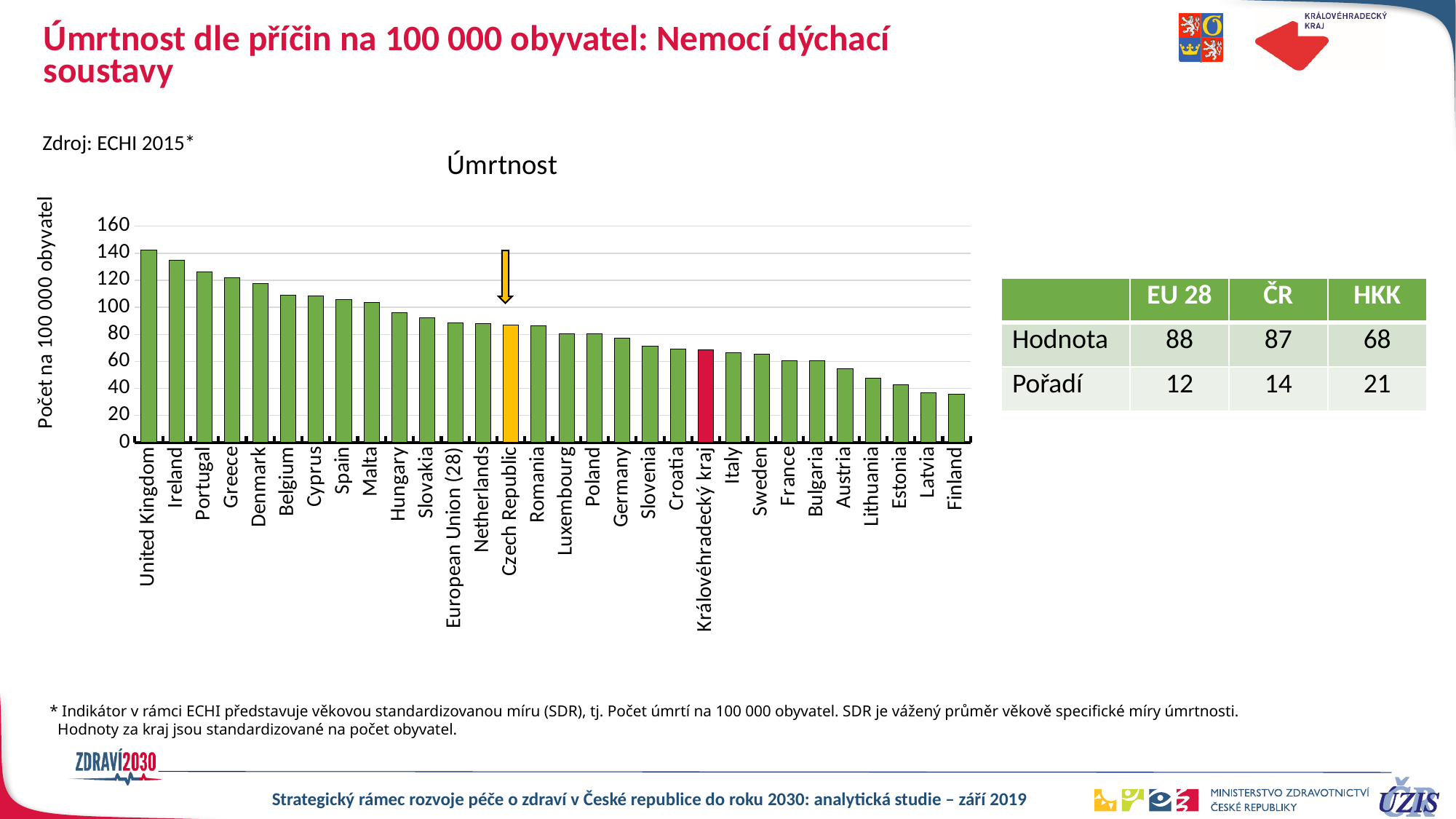
Is the value for Lithuania greater or less than 60? less Is the value for Ireland greater or less than 120? greater Which category has the highest value in the chart? United Kingdom Which has a larger value, Spain or Italy? Spain What is the difference between the values for European Union (28) and Královéhradecký kraj? 20 Do the values rise or fall from left to right along the x axis? fall What is the value for Královéhradecký kraj? 68 How many categories (bars) does the chart show? 30 What is the value for Czech Republic? 87 What is the value for European Union (28)? 88 What colour is the bar for Královéhradecký kraj? red What kind of chart is shown on the slide? bar chart